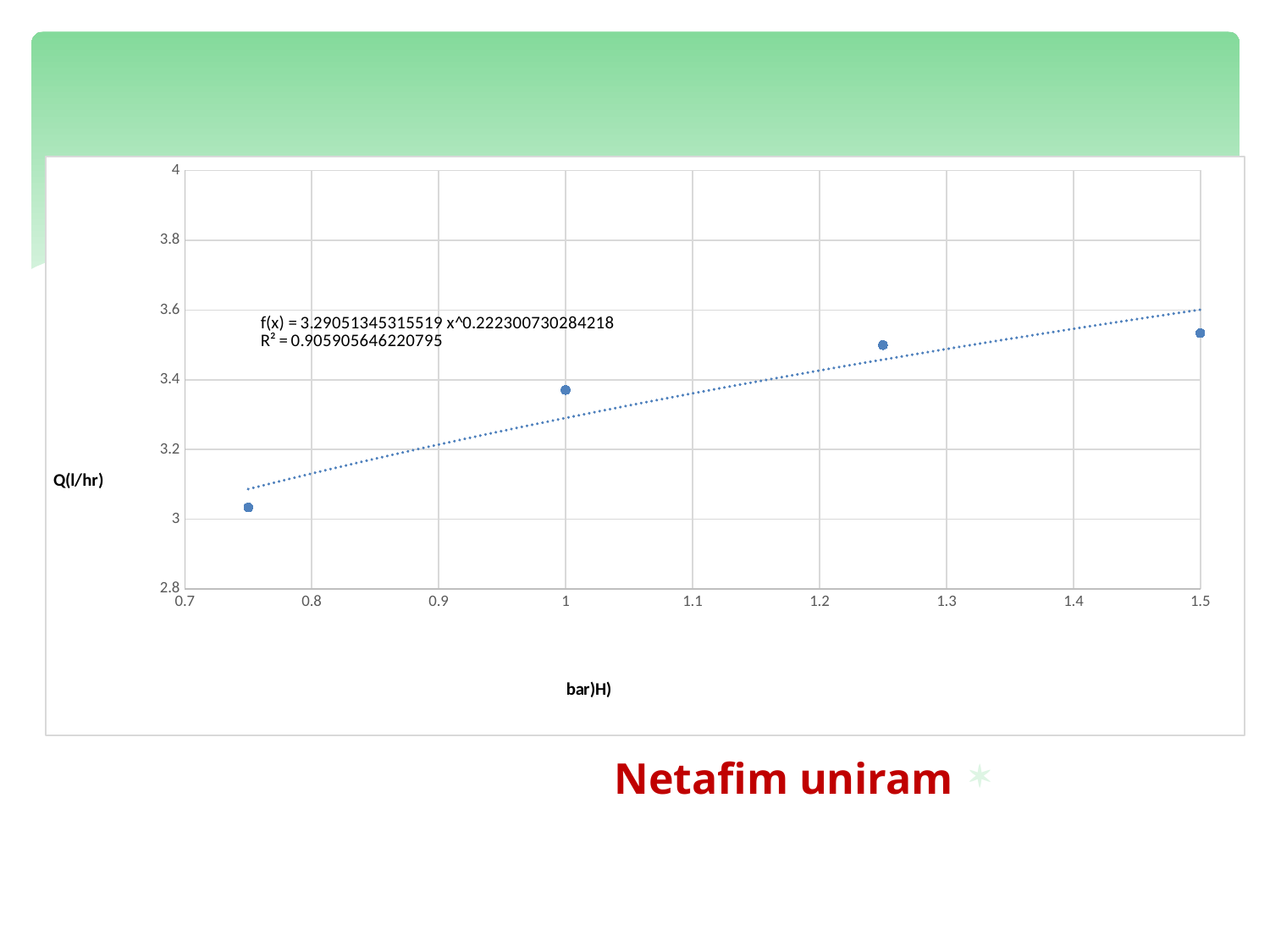
Is the value for the point at x = 1.25 greater or less than 3.4? greater Do the plotted values rise or fall as the x-axis value increases? Rise Which point has the larger value: the one at x = 1 or the one at x = 1.25? x = 1.25 What R² value is shown for the trendline on the chart? 0.905905646220795 Is the value for the point at x = 1.5 greater or less than 3.6? less What kind of chart is shown on the slide? Scatter chart Which point has the larger value: the one at x = 0.75 or the one at x = 1? x = 1 How many data points are plotted on the chart? 4 Is the value for the point at x = 1 greater or less than 3.2? greater What is the label on the y-axis of the chart? Q(l/hr)